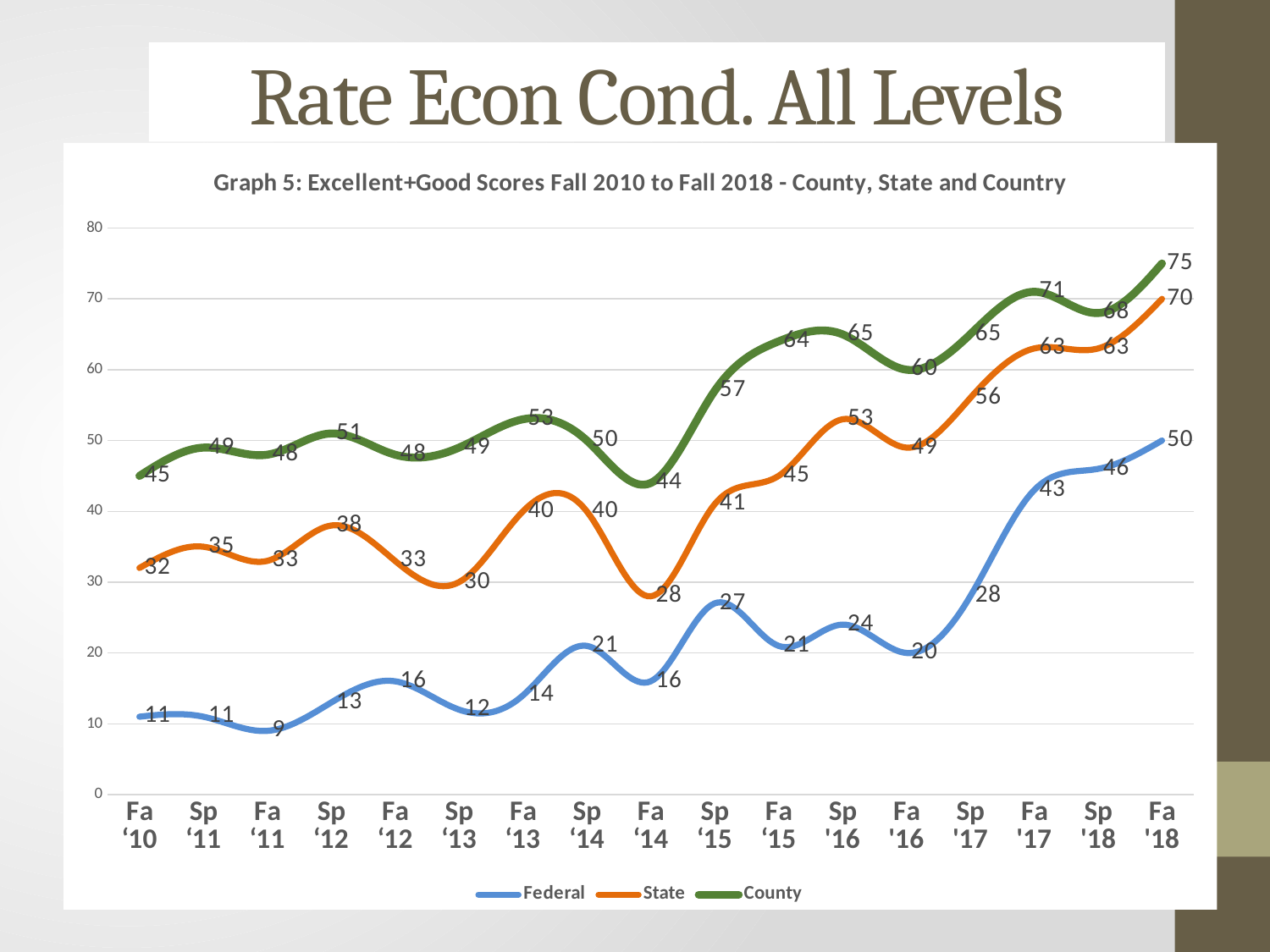
At which time point is the State series highest? Fa '18 How many time points are plotted along the x axis? 17 At which time point is the Federal series lowest? Fa '11 What is the Federal value at Fa '11? 9 Which series is drawn in green? County What is the difference between the County and Federal values at Fa '18? 25 What is the State value at Sp '16? 53 What is the County value at Fa '18? 75 What type of chart is shown on the slide? line chart Which is larger at Fa '14: the State value or the Federal value? State How many series does the legend list? 3 Does the Federal series generally rise or fall from Fa '10 to Fa '18? rise